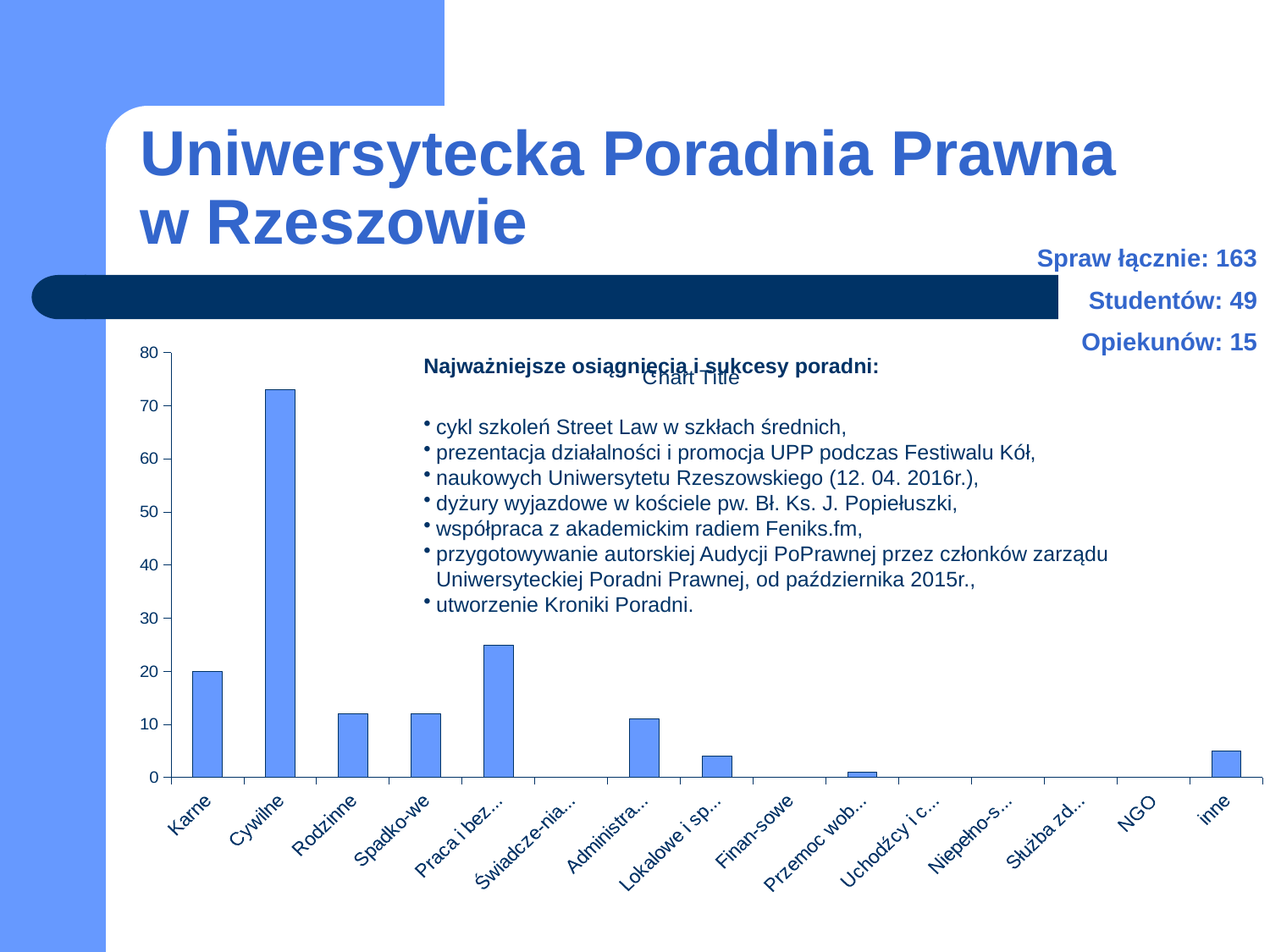
Is the value for Cywilne greater or less than 60? greater Is the value for Karne greater or less than 30? less Is the value for inne greater or less than 10? less Which category has the highest bar in the chart? Cywilne Which is larger, the value for Finan-sowe or the value for inne? inne How many categories are shown on the x axis of the chart? 15 Which is larger, the value for Cywilne or the value for Karne? Cywilne What title is displayed above the chart? Chart Title What kind of chart is shown on the slide? bar chart Which is larger, the value for Karne or the value for Rodzinne? Karne